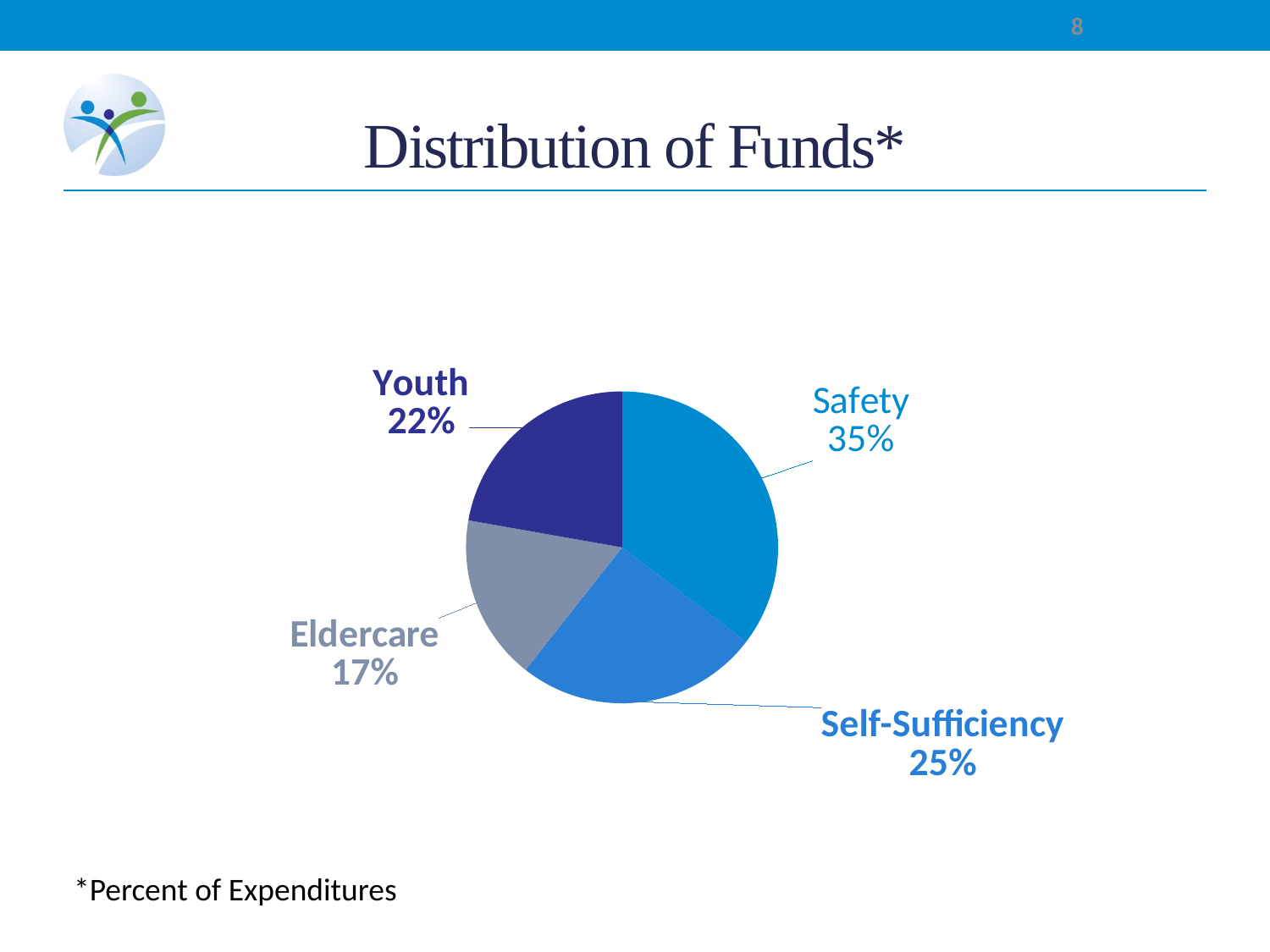
Which category receives the largest share of funds? Safety What is the difference in percentage points between Safety and Self-Sufficiency? 10 According to the footnote, what do the percentages represent? Percent of Expenditures Which receives a larger share of funds, Youth or Eldercare? Youth Which category receives the smallest share of funds? Eldercare What kind of chart is shown on the slide? Pie chart What percentage of funds goes to Youth? 22% What is the title of the chart? Distribution of Funds* What percentage of funds goes to Safety? 35% How many categories are shown in the pie chart? 4 What percentage of funds goes to Eldercare? 17% What percentage of funds goes to Self-Sufficiency? 25%